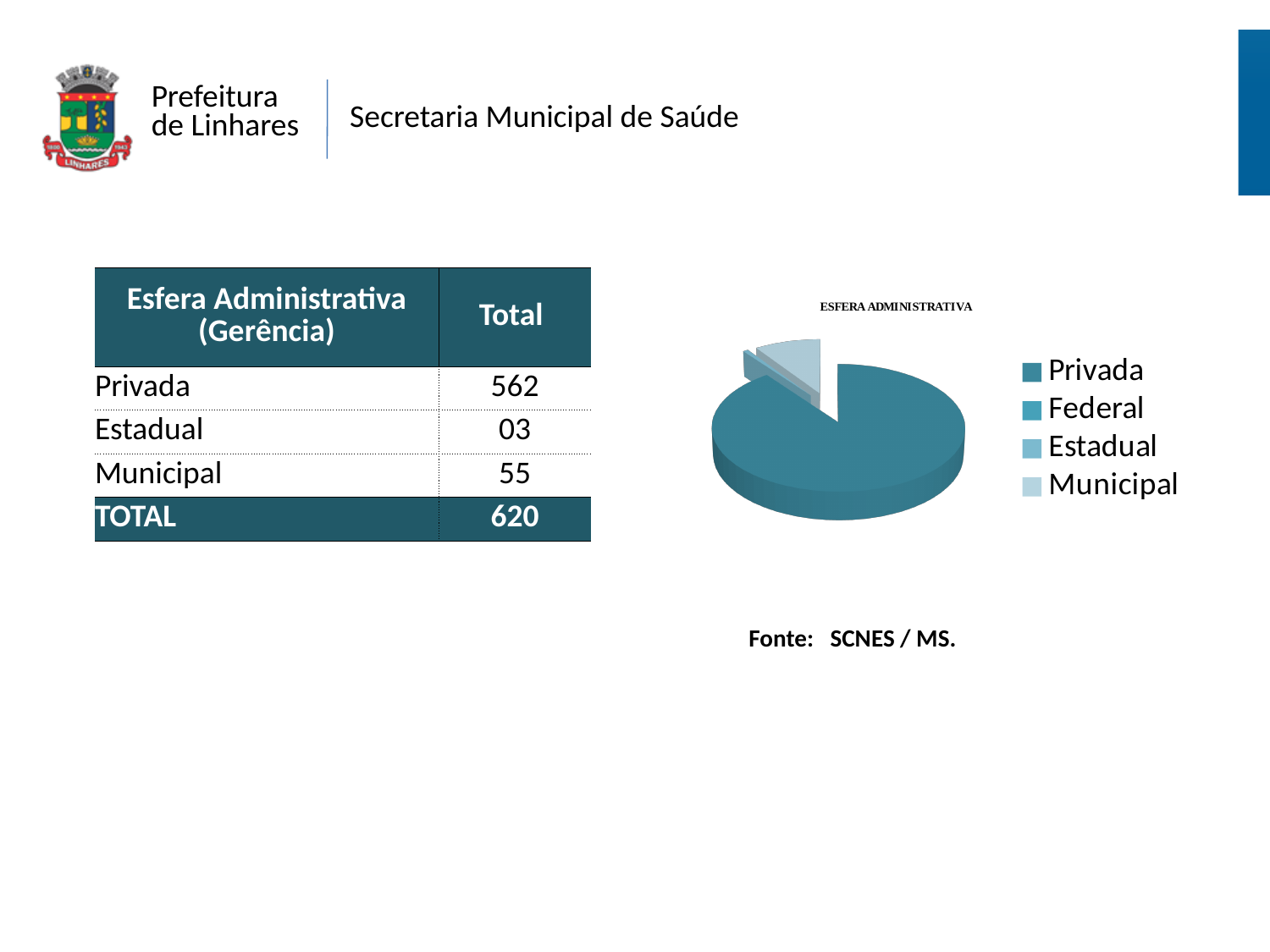
Using the table values, what is the difference between Privada and Municipal? 507 Which is larger in the pie chart, the Municipal slice or the Estadual slice? Municipal What is the title of the pie chart? ESFERA ADMINISTRATIVA How many entries does the legend of the pie chart list? 4 Which category takes up the largest slice of the pie chart? Privada According to the table next to the pie chart, what is the total for Municipal? 55 According to the table next to the pie chart, what is the total for Privada? 562 What is the overall TOTAL shown in the table next to the pie chart? 620 According to the table next to the pie chart, what is the total for Estadual? 03 Using the table values, what is the difference between Municipal and Estadual? 52 Which category is listed second in the pie chart's legend? Federal What kind of chart is shown under the title ESFERA ADMINISTRATIVA? pie chart